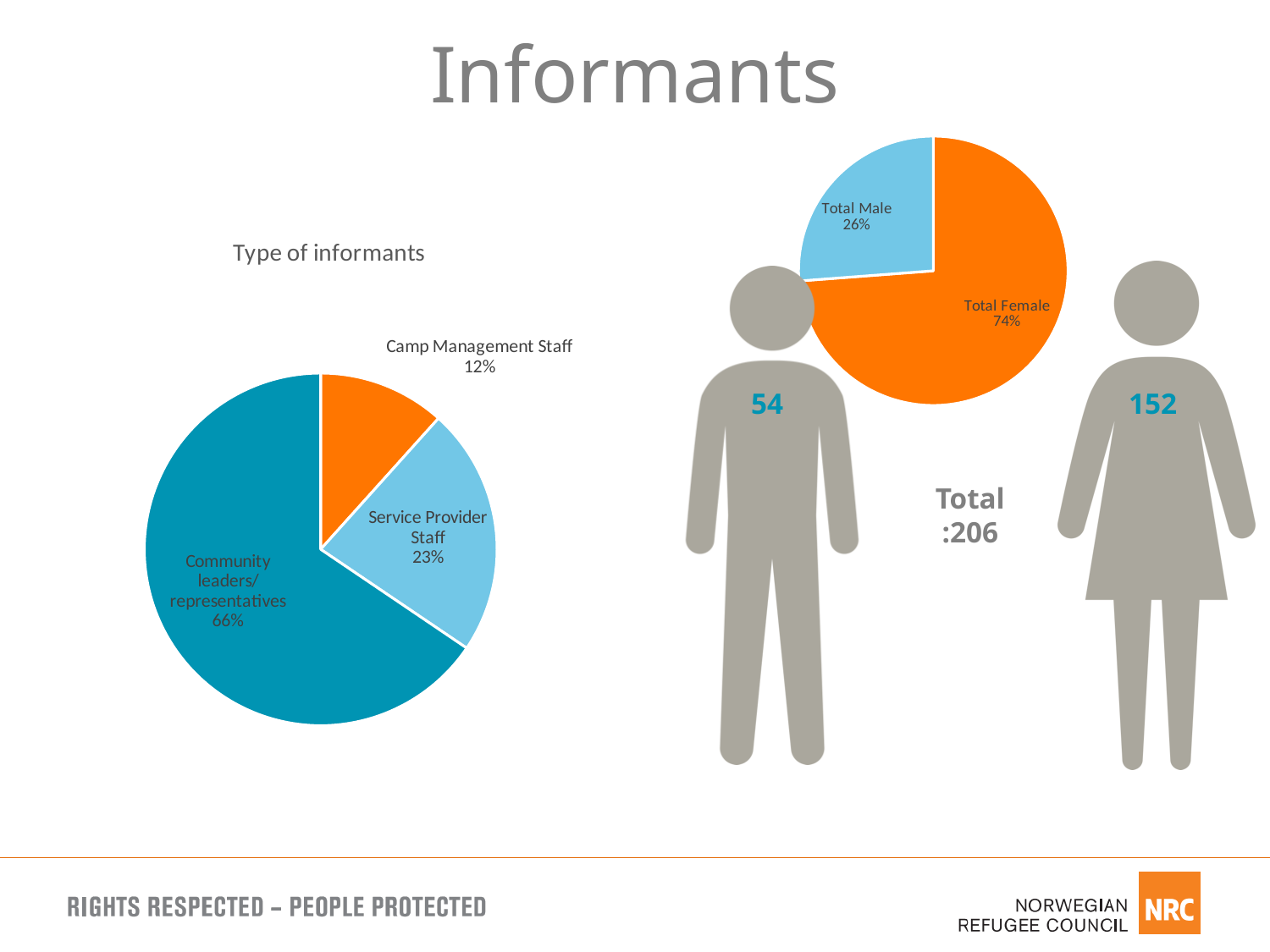
In the 'Type of informants' pie chart, what share do Camp Management Staff have? 12% In the 'Type of informants' pie chart, which category has the smallest share? Camp Management Staff In the 'Type of informants' pie chart, what is the difference in percentage points between Service Provider Staff and Camp Management Staff? 11 percentage points In the 'Type of informants' pie chart, what share do Service Provider Staff have? 23% In the pie chart on the right, what share is Total Female? 74% In the 'Type of informants' pie chart, which category has the largest share? Community leaders/representatives What kind of chart is the 'Type of informants' chart? Pie chart In the pie chart on the right, what share is Total Male? 26% In the pie chart on the right, what colour is the Total Male slice? Light blue In the pie chart on the right, which is larger, Total Male or Total Female? Total Female In the 'Type of informants' pie chart, what share do Community leaders/representatives have? 66% In the 'Type of informants' pie chart, how many categories are shown? 3